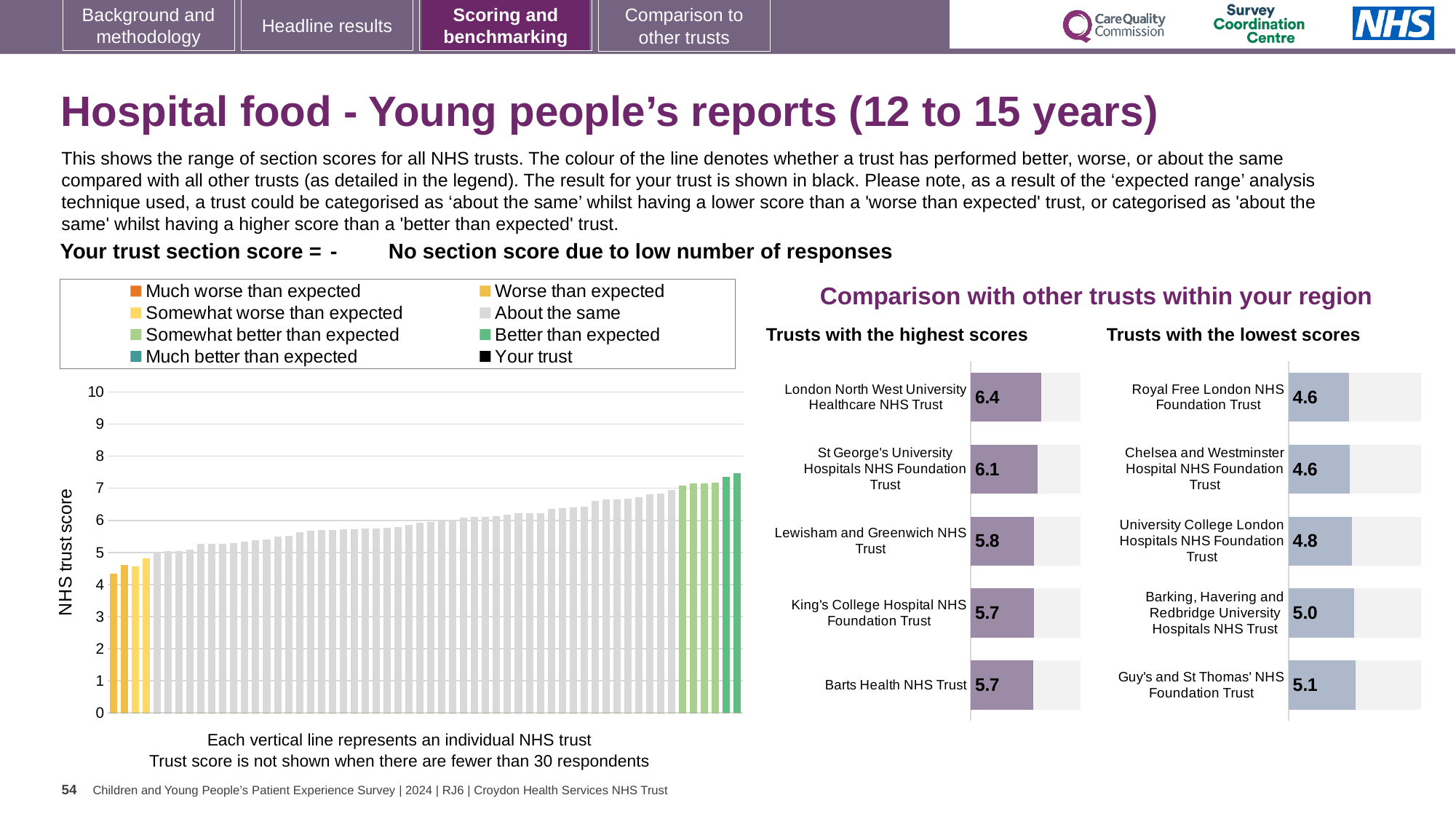
In the 'Trusts with the highest scores' chart, what is the score for London North West University Healthcare NHS Trust? 6.4 In the 'Trusts with the lowest scores' chart, which has the larger score: Barking, Havering and Redbridge University Hospitals NHS Trust or Royal Free London NHS Foundation Trust? Barking, Havering and Redbridge University Hospitals NHS Trust How many trusts are shown in the 'Trusts with the highest scores' chart? 5 In the 'Trusts with the lowest scores' chart, what is the score for University College London Hospitals NHS Foundation Trust? 4.8 In the large chart on the left, is the value of the leftmost bar greater or less than 5? less In the 'Trusts with the lowest scores' chart, what is the score for Guy's and St Thomas' NHS Foundation Trust? 5.1 What kind of chart is the large chart on the left showing NHS trust scores? Bar chart In the large chart on the left, do the NHS trust scores rise or fall from left to right? Rise In the 'Trusts with the highest scores' chart, which trust has the highest score? London North West University Healthcare NHS Trust In the 'Trusts with the lowest scores' chart, which trust has the highest score shown? Guy's and St Thomas' NHS Foundation Trust How many entries does the legend above the large chart on the left list? 8 In the 'Trusts with the highest scores' chart, what is the difference between the scores of London North West University Healthcare NHS Trust and Lewisham and Greenwich NHS Trust? 0.6